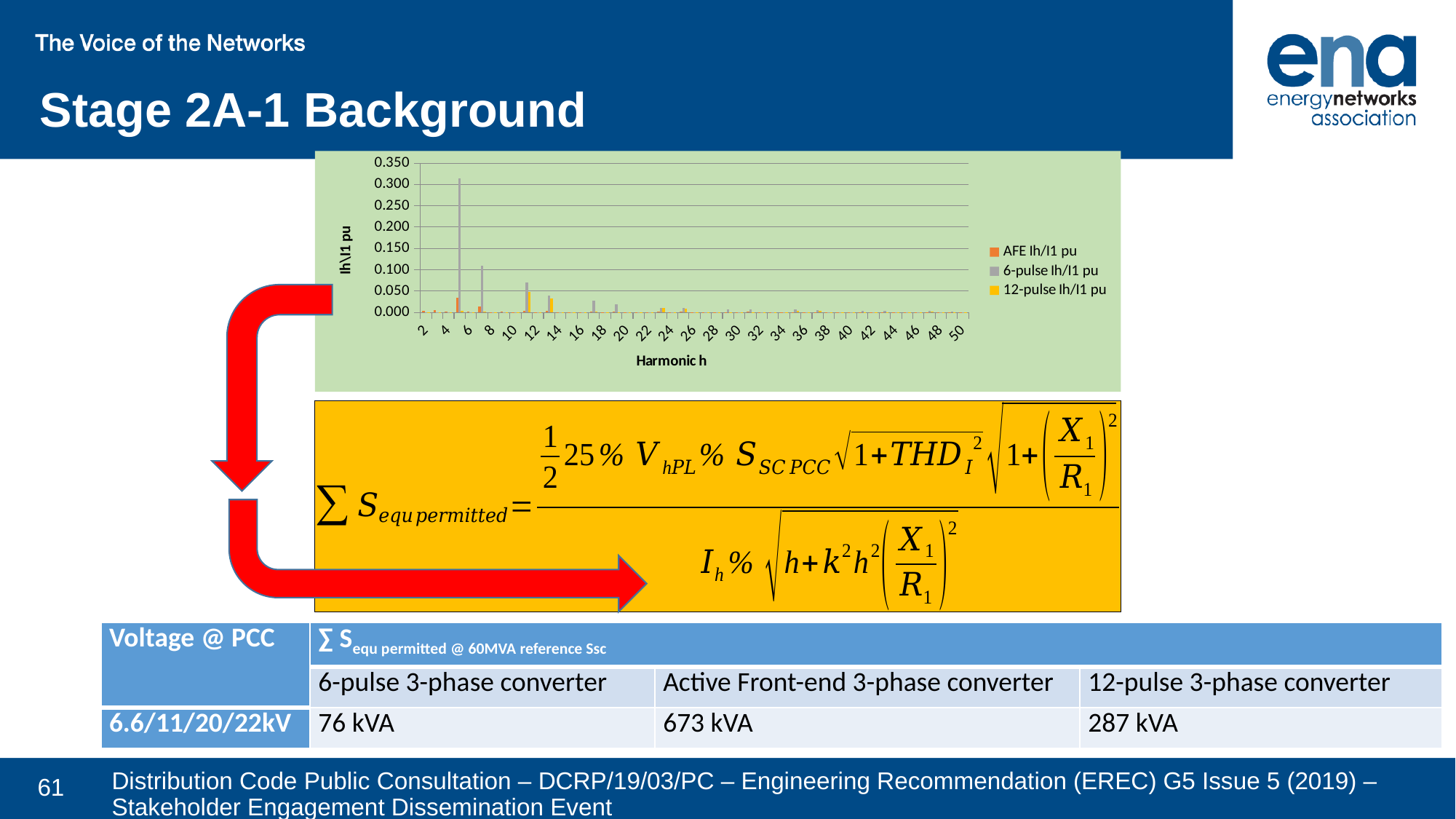
At which harmonic does the 6-pulse Ih/I1 pu series reach its highest value? 5 Is the value of the 6-pulse Ih/I1 pu series at harmonic 7 greater or less than 0.150? less How many series does the chart legend list? 3 Which series is shown in yellow in the chart? 12-pulse Ih/I1 pu Which series has the tallest bar in the chart? 6-pulse Ih/I1 pu Is the value of the 12-pulse Ih/I1 pu series at harmonic 11 greater or less than 0.100? less What is the title of the chart's x axis? Harmonic h What are the three series listed in the chart legend? AFE Ih/I1 pu, 6-pulse Ih/I1 pu, 12-pulse Ih/I1 pu At harmonic 5, which is larger: the 6-pulse Ih/I1 pu value or the 12-pulse Ih/I1 pu value? 6-pulse Ih/I1 pu Is the highest value of the 6-pulse Ih/I1 pu series greater or less than 0.250? greater Do the harmonic current values generally rise or fall as the harmonic number increases along the x axis? fall What kind of chart is shown on the slide? bar chart